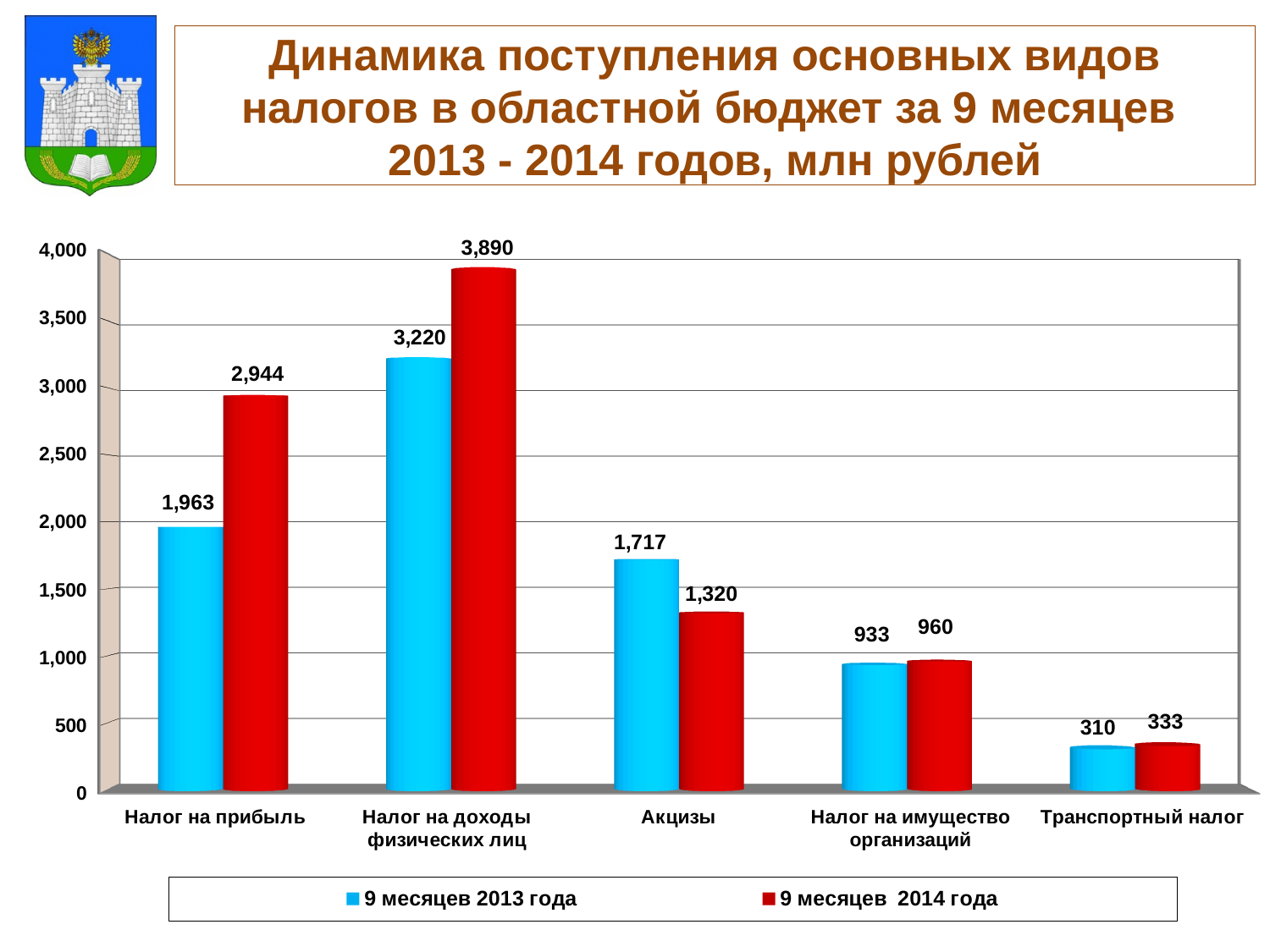
What is the value for Налог на доходы физических лиц for 9 месяцев 2014 года? 3,890 What is the value for Акцизы for 9 месяцев 2014 года? 1,320 What is the value for Налог на прибыль for 9 месяцев 2013 года? 1,963 What colour are the bars for 9 месяцев 2014 года? Red Which category has the lowest value for 9 месяцев 2013 года? Транспортный налог How many series does the legend list? 2 Which category has the highest value for 9 месяцев 2014 года? Налог на доходы физических лиц What kind of chart is shown on the slide? Bar chart What is the value for Транспортный налог for 9 месяцев 2013 года? 310 How many tax categories are shown on the x axis? 5 What is the difference between the 2014 and 2013 values for Налог на прибыль? 981 Which is larger for Акцизы: the value for 9 месяцев 2013 года or 9 месяцев 2014 года? 9 месяцев 2013 года